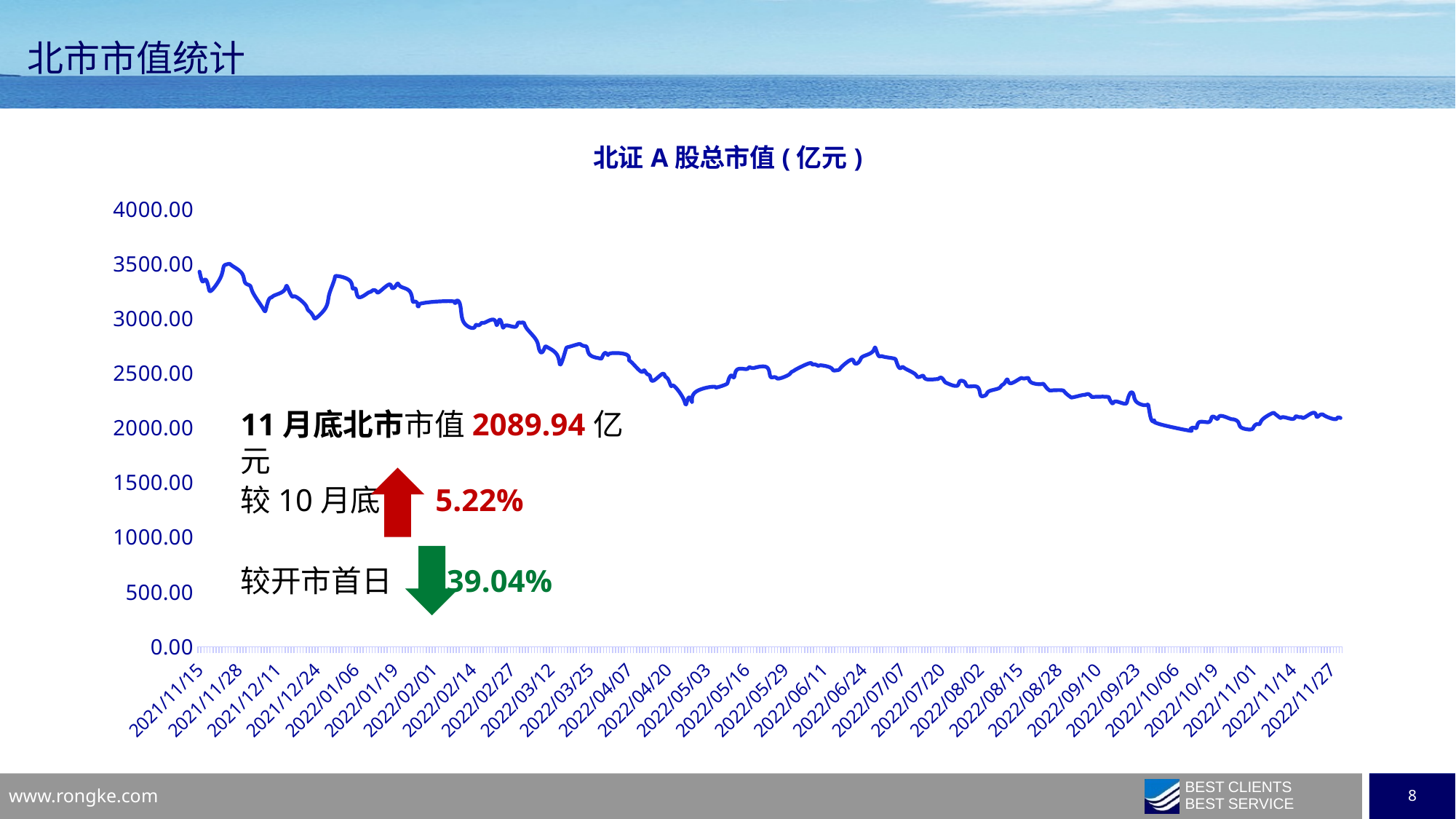
What kind of chart is shown on the slide? line chart Is the value at 2021/11/15 greater or less than 3000? greater Is the value at 2022/05/03 greater or less than 2500? less Is the value at 2022/06/24 greater or less than 2500? greater According to the annotation on the slide, what was the 北市 market value at the end of November? 2089.94 亿元 Overall, do the values rise or fall from 2021/11/15 to 2022/11/27? fall What is the title of the chart? 北证A股总市值（亿元） Which is higher, the value at 2021/11/15 or the value at 2022/11/27? 2021/11/15 What is the highest value shown on the y axis? 4000.00